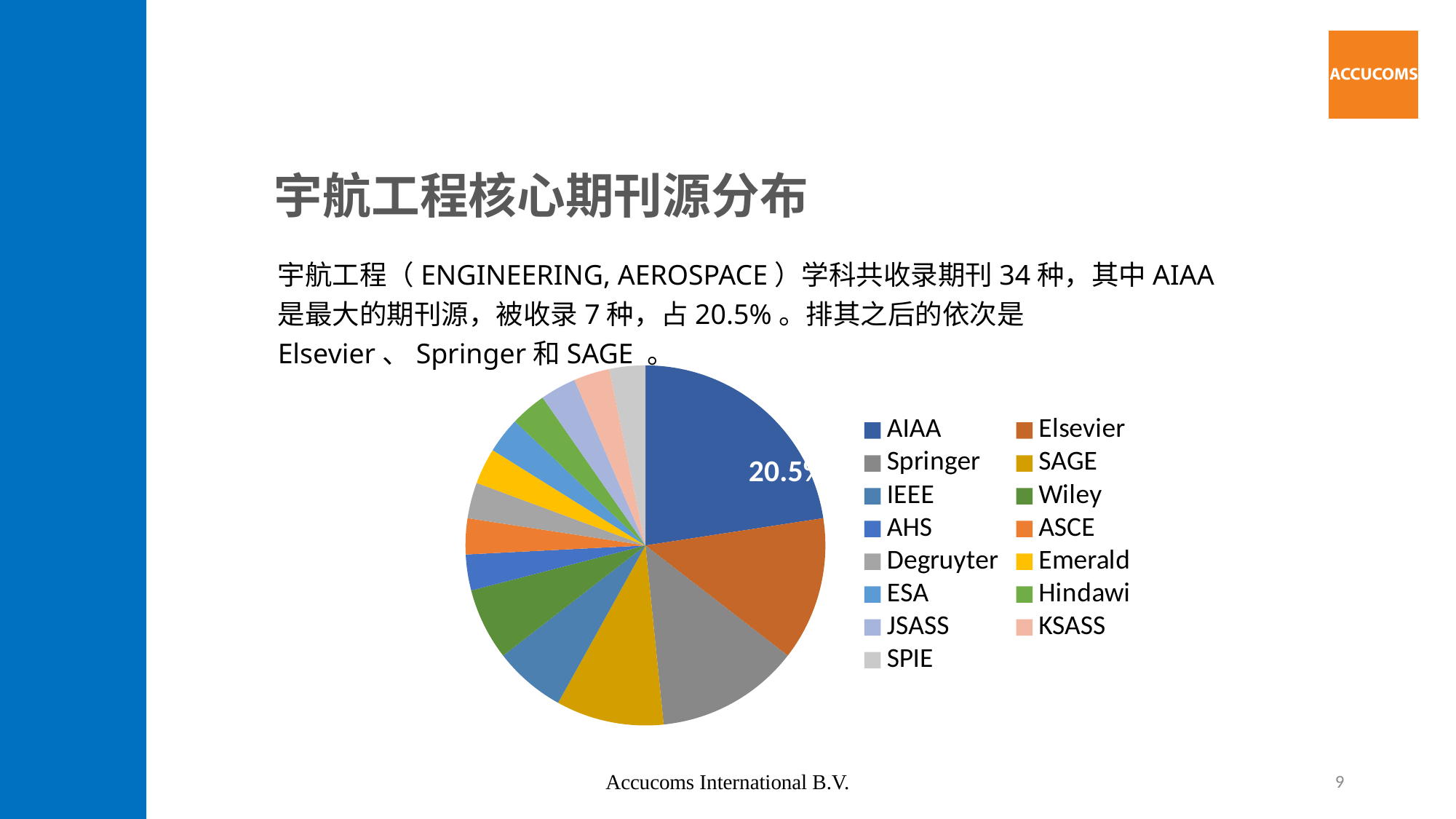
Which is the only slice in the pie chart that has a percentage data label? AIAA What kind of chart is shown on the slide? pie chart How many categories (slices) does the pie chart have? 15 Which slice is larger, AIAA or Elsevier? AIAA What share of the pie does AIAA account for, according to the data label? 20.5% What colour is the AIAA slice in the pie chart? blue Which slice is larger, Elsevier or AHS? Elsevier Which slice is larger, SAGE or SPIE? SAGE Which category has the largest slice in the pie chart? AIAA